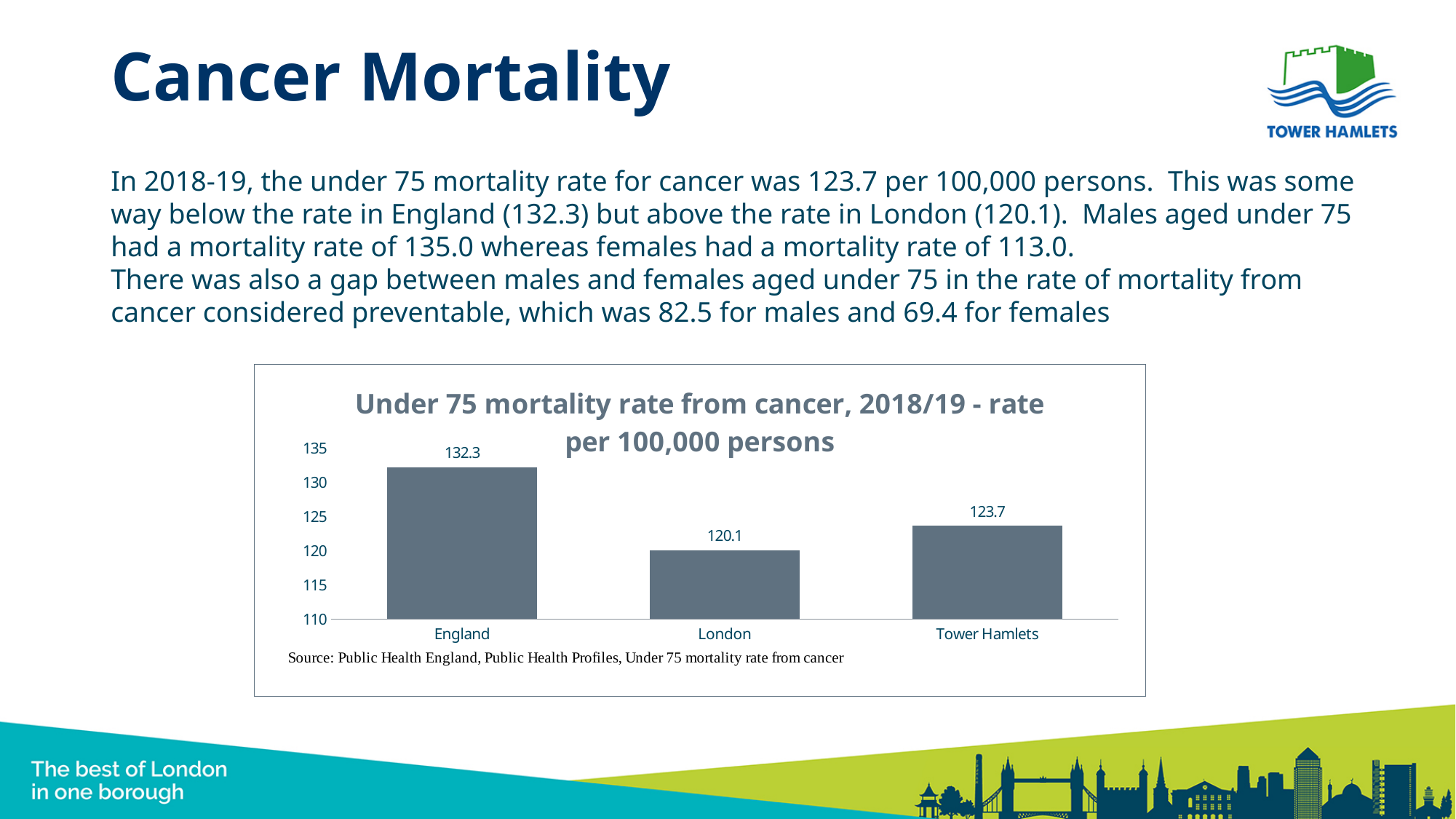
How many areas are shown in the chart? 3 What is the title of the chart? Under 75 mortality rate from cancer, 2018/19 - rate per 100,000 persons Which has a higher under 75 cancer mortality rate, London or Tower Hamlets? Tower Hamlets What is the under 75 mortality rate from cancer for Tower Hamlets in the chart? 123.7 Which area has the highest under 75 mortality rate from cancer in the chart? England What is the difference between the under 75 cancer mortality rates for Tower Hamlets and London? 3.6 What kind of chart is shown on the slide? Bar chart Which area has the lowest under 75 mortality rate from cancer in the chart? London What is the difference between the under 75 cancer mortality rates for England and Tower Hamlets? 8.6 Is the value for England greater or less than 130? greater What is the under 75 mortality rate from cancer for London in the chart? 120.1 What is the under 75 mortality rate from cancer for England in the chart? 132.3